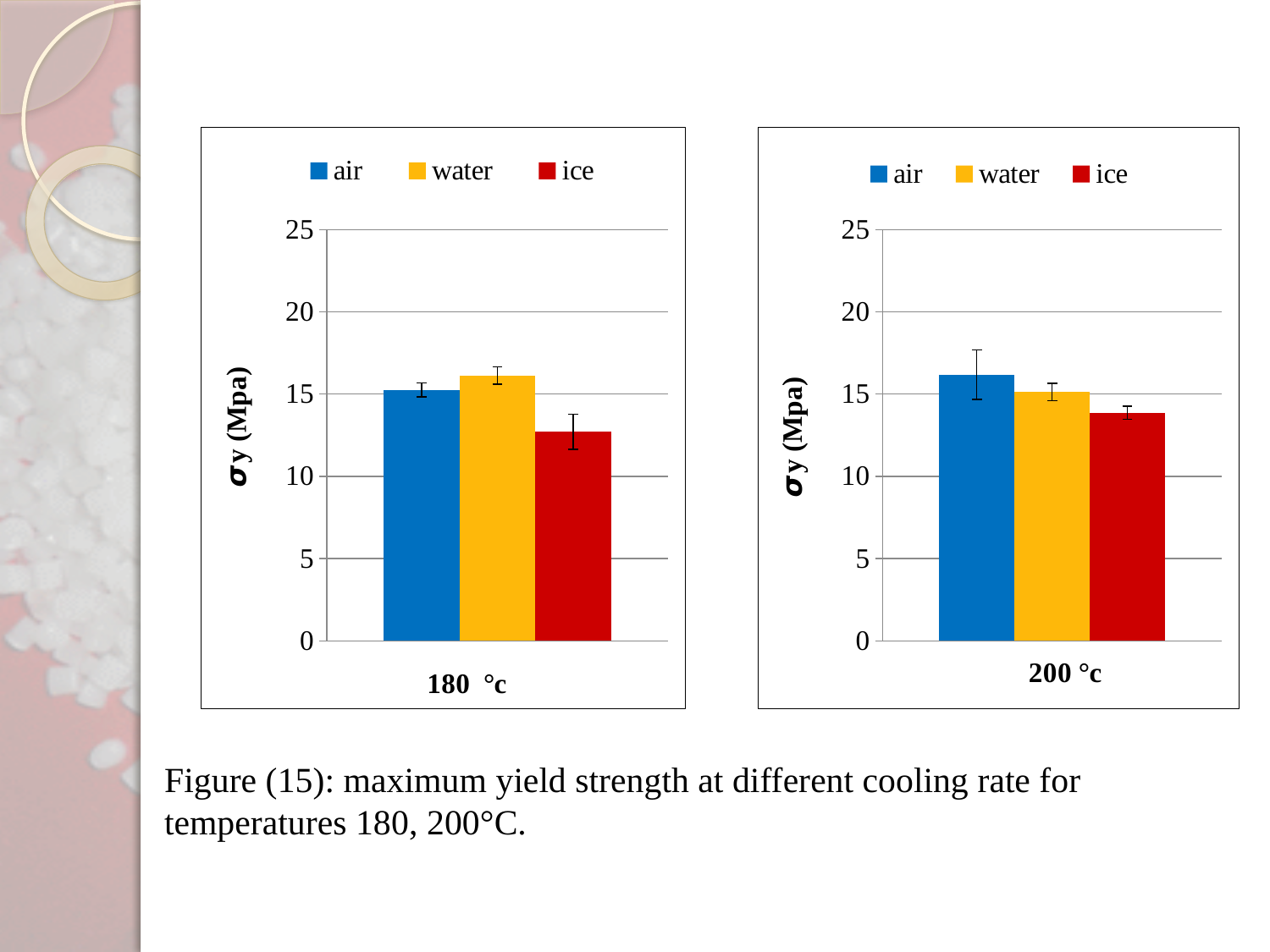
In the chart labelled 200 °c, which cooling medium has the lowest yield strength? ice In the chart labelled 180 °c, which cooling medium has the highest yield strength? water What kind of chart is the chart labelled 180 °c on the left? bar chart In the chart labelled 180 °c, is the value for water greater or less than 15? greater In the chart labelled 200 °c, which is larger, the value for air or the value for ice? air In the chart labelled 180 °c, which cooling medium has the lowest yield strength? ice In the chart labelled 200 °c, is the value for ice greater or less than 15? less How many series does the legend of the chart labelled 200 °c list? 3 In the chart labelled 200 °c, which cooling medium has the highest yield strength? air How many bars are plotted in the chart labelled 180 °c? 3 What colour represents ice in the legend of the chart labelled 200 °c? red In the chart labelled 180 °c, is the value for ice greater or less than 15? less